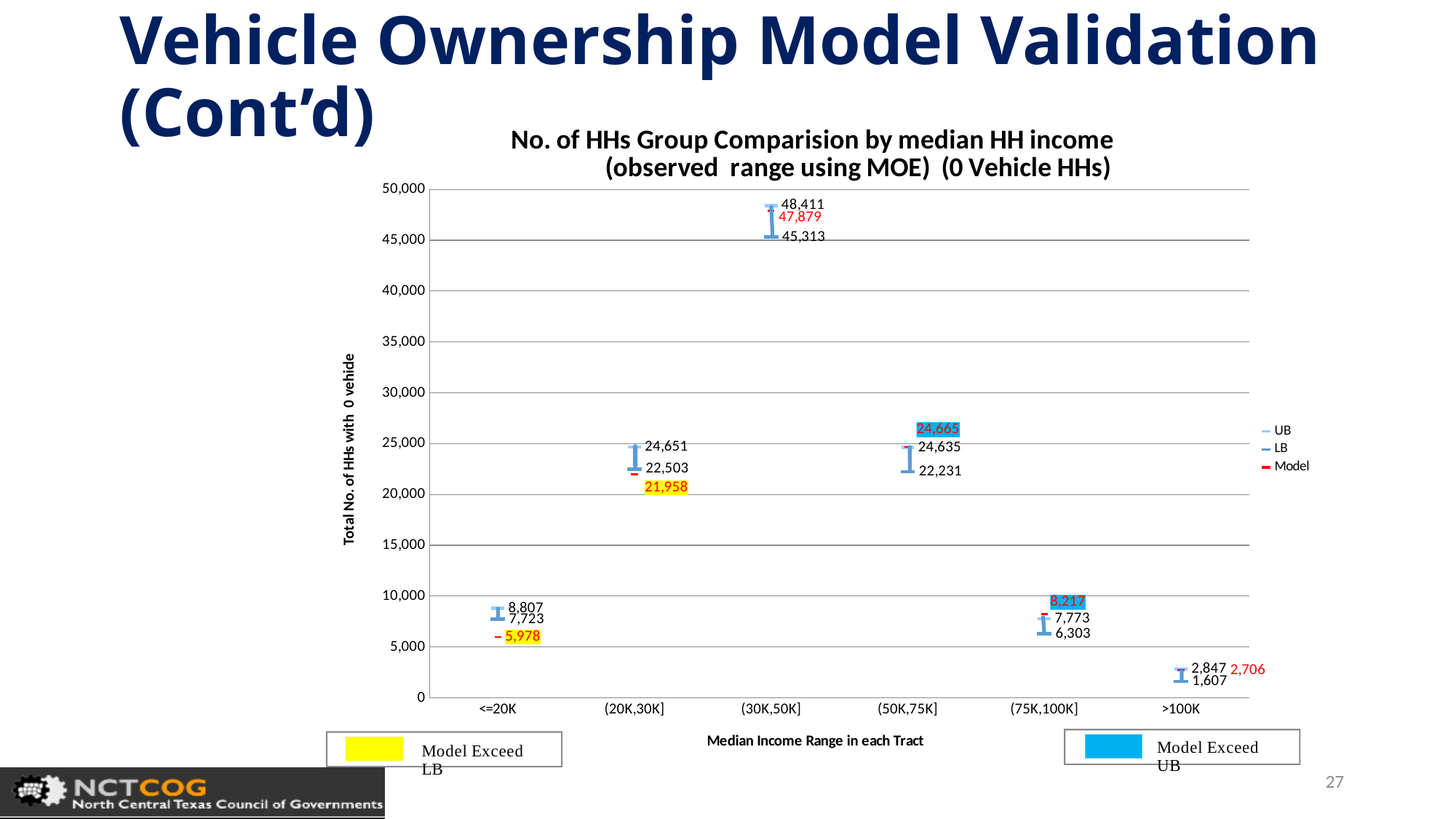
Which is larger for the (75K,100K] income range, the Model value or the UB value? Model value What is the Model value for the <=20K income range? 5,978 How many income range categories are shown on the x axis? 6 What is the difference between the UB and LB values for the (20K,30K] income range? 2,148 Which income range has the lowest LB value? >100K Which income range has the highest Model value? (30K,50K] How many series does the legend list? 3 What is the UB value for the (30K,50K] income range? 48,411 What is the Model value for the >100K income range? 2,706 What does the yellow highlight indicate according to the key below the chart? Model Exceed LB What is the LB value for the (50K,75K] income range? 22,231 What is the label of the y axis? Total No. of HHs with 0 vehicle